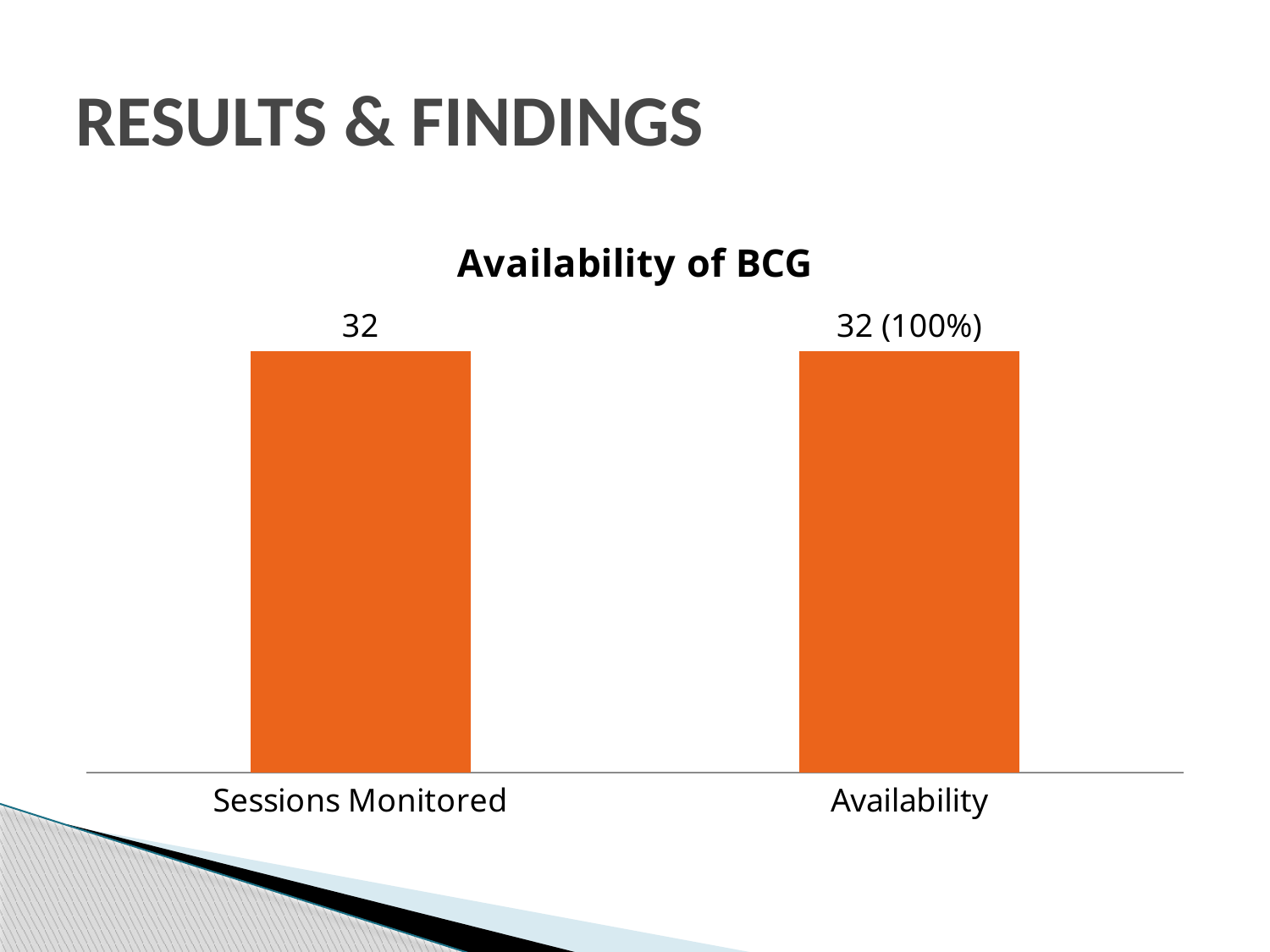
What kind of chart is shown on the slide? bar chart What colour are the bars in the chart? orange What percentage is shown in the data label for Availability? 100% What is the value shown for Sessions Monitored? 32 What is the label of the first category on the x axis? Sessions Monitored How many categories are shown on the x axis of the chart? 2 What is the difference between the value for Sessions Monitored and the value for Availability? 0 What is the data label shown on the Availability bar? 32 (100%) What is the title of the chart? Availability of BCG